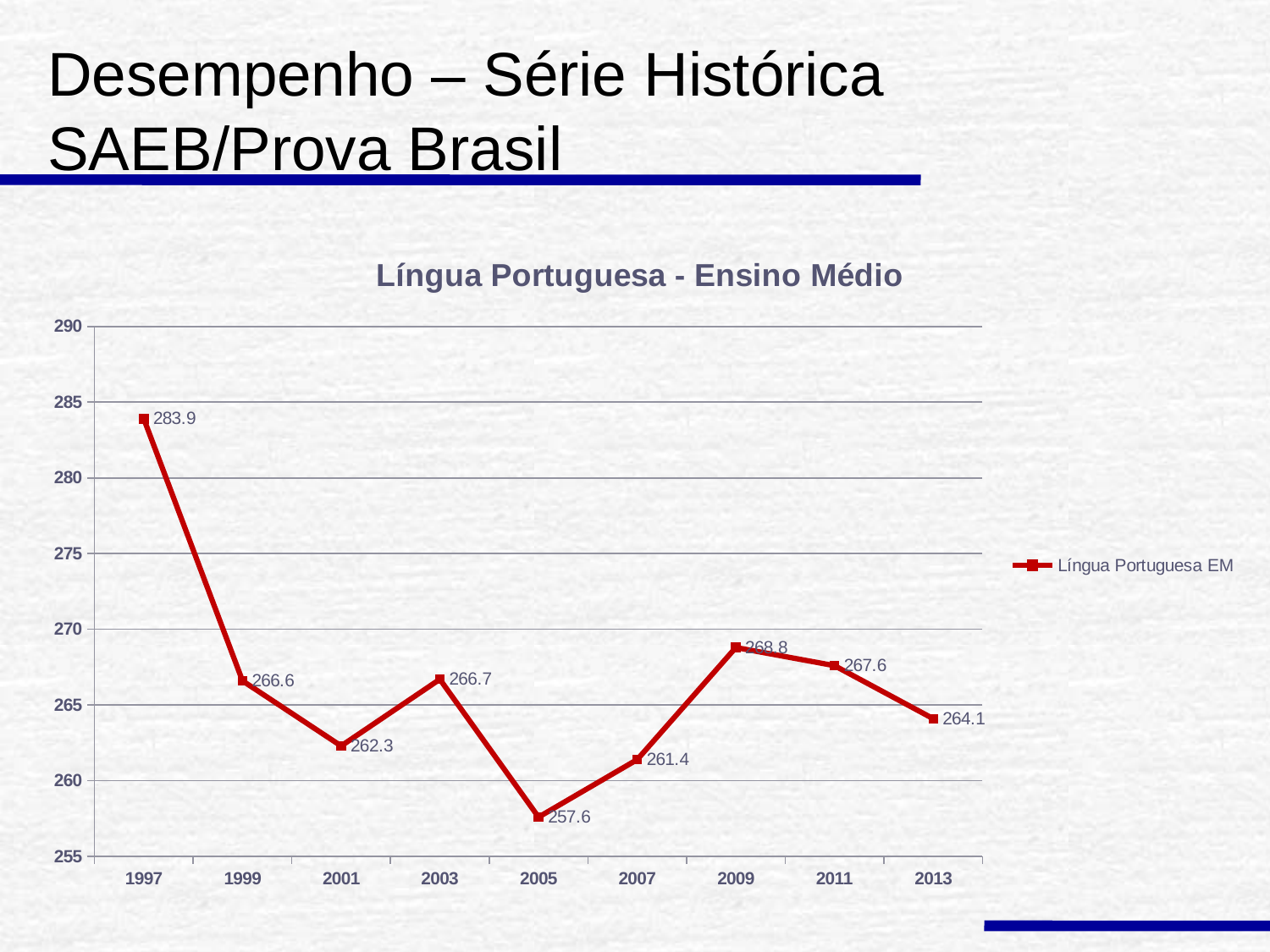
What is the value for 2005? 257.6 Which year has the highest value? 1997 What is the value for 2013? 264.1 What kind of chart is shown? line chart What is the difference between the values for 1997 and 2013? 19.8 Which is larger, the value for 2009 or the value for 2011? 2009 How many years are plotted on the x axis? 9 Is the value for 2007 greater or less than 265? less How many series does the legend list? 1 What is the value for 1997? 283.9 What is the title of the chart? Língua Portuguesa - Ensino Médio Which year has the lowest value? 2005